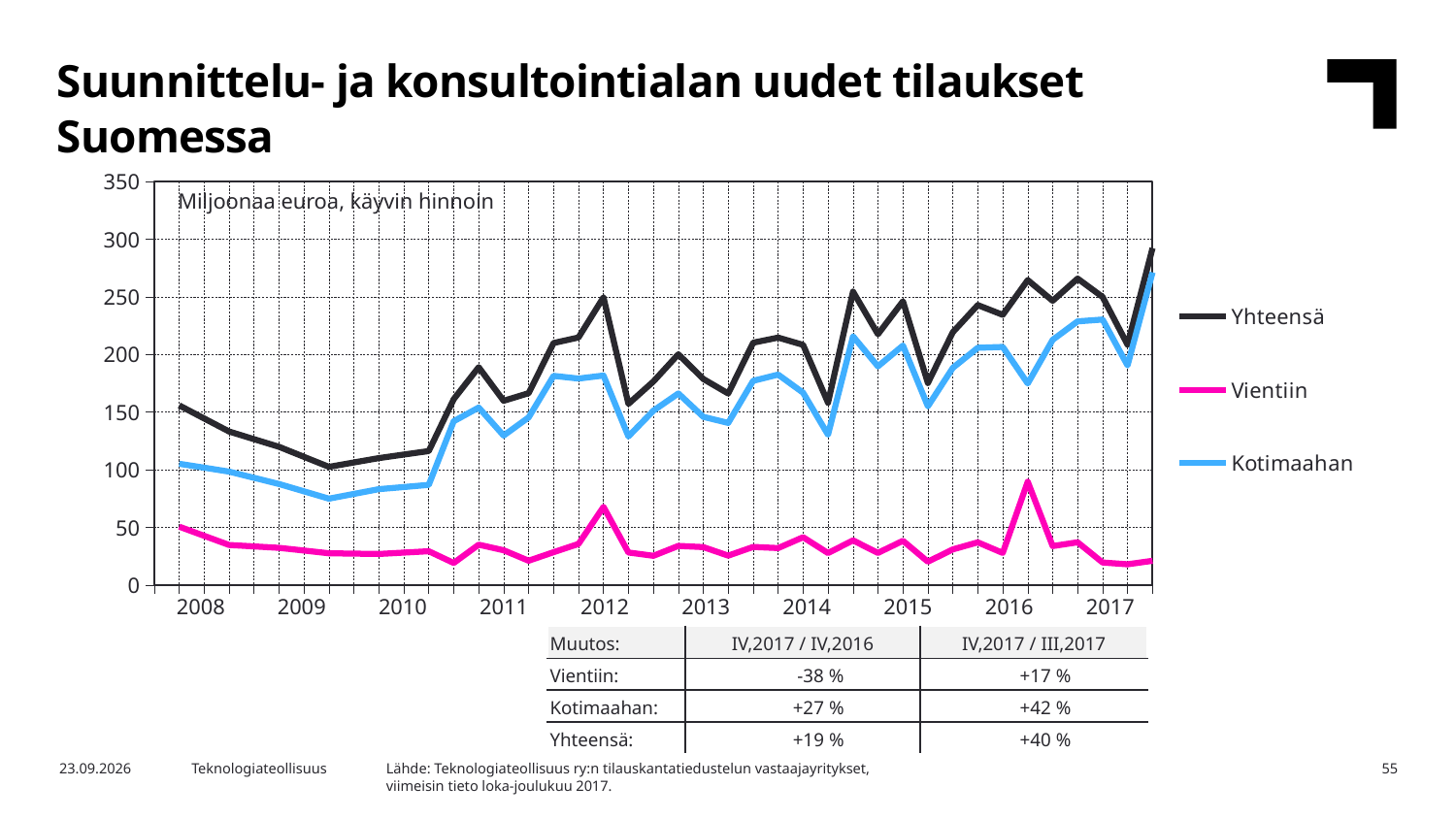
Is the lowest value for Kotimaahan in 2009 greater or less than 100? less Is the peak value for Vientiin in 2016 greater or less than 50? greater What are the three series named in the legend? Yhteensä, Vientiin, Kotimaahan Is the value for Yhteensä at the last point in 2017 greater or less than 250? greater Which is larger in 2015, Kotimaahan or Vientiin? Kotimaahan How many series does the legend list? 3 Which series has the lowest values throughout the chart? Vientiin How many year labels are shown on the x axis? 10 What unit is stated in the chart's annotation? Miljoonaa euroa, käyvin hinnoin What kind of chart is shown on the slide? line chart Which series has the highest values throughout the chart? Yhteensä Does the Yhteensä line rise or fall from 2009 to the start of 2012? rise